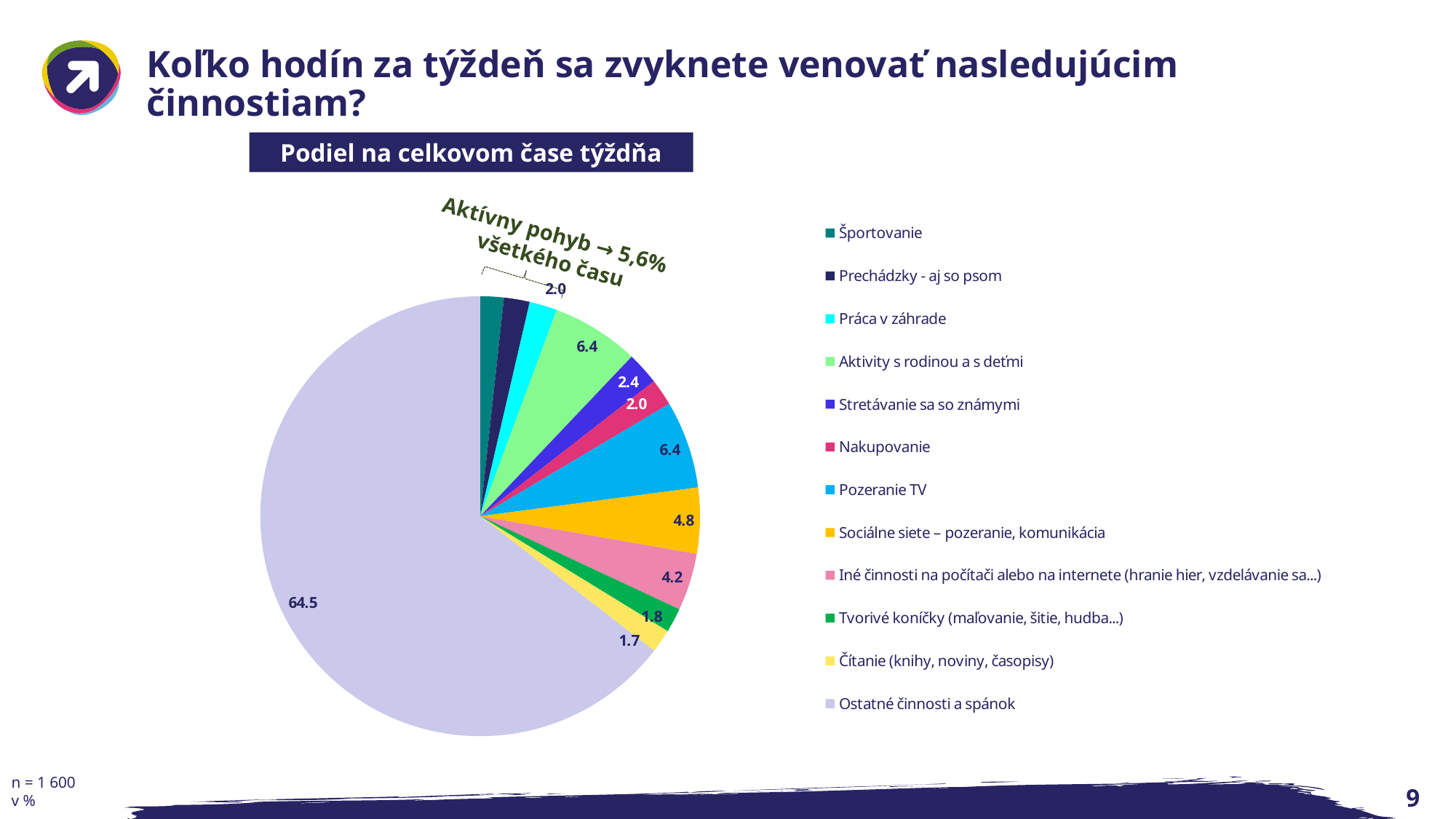
What is the value for Čítanie (knihy, noviny, časopisy)? 1.7 What type of chart is shown on the slide? pie chart Which category has the largest slice of the pie? Ostatné činnosti a spánok What is the value for Pozeranie TV? 6.4 What is the title shown above the pie chart? Podiel na celkovom čase týždňa Which is larger, Sociálne siete – pozeranie, komunikácia or Iné činnosti na počítači alebo na internete? Sociálne siete – pozeranie, komunikácia How many categories does the legend list? 12 According to the annotation on the chart, what share of all time does Aktívny pohyb account for? 5,6% What is the value for Ostatné činnosti a spánok? 64.5 What is the value for Sociálne siete – pozeranie, komunikácia? 4.8 What is the difference between the values for Pozeranie TV and Sociálne siete – pozeranie, komunikácia? 1.6 What is the value for Stretávanie sa so známymi? 2.4